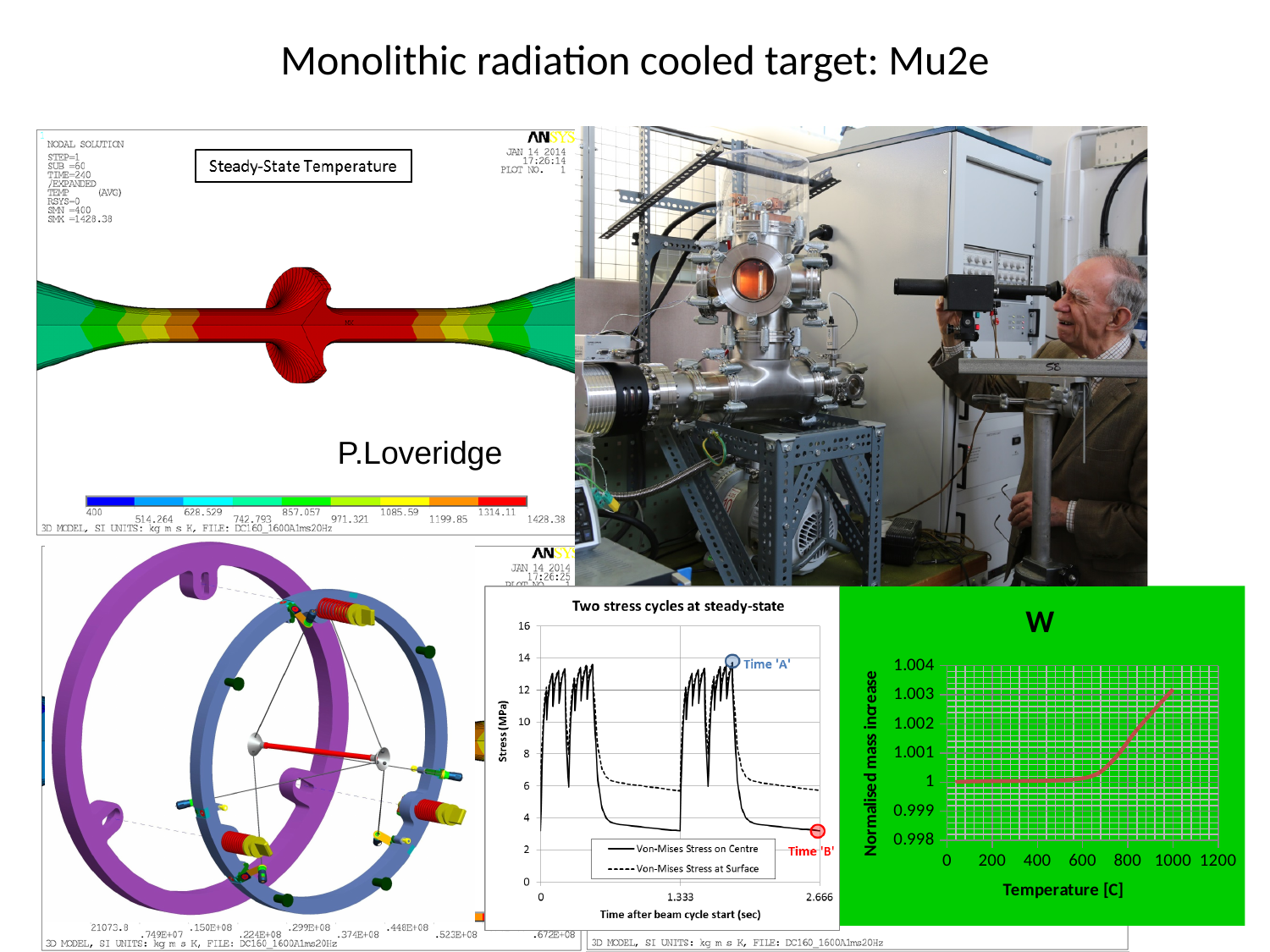
In the 'Two stress cycles at steady-state' chart, is the peak Von-Mises Stress on Centre greater or less than 12 MPa? greater In the 'Two stress cycles at steady-state' chart, what is the largest tick value shown on the x axis? 2.666 In the 'Two stress cycles at steady-state' chart, is the Von-Mises Stress on Centre at Time 'B' greater or less than 4 MPa? less In the 'Two stress cycles at steady-state' chart, how many series does the legend list? 2 What kind of chart is 'Two stress cycles at steady-state'? line chart What kind of chart is the 'W' chart on the green background? line chart In the 'Two stress cycles at steady-state' chart, what is the label of the x axis? Time after beam cycle start (sec) In the 'Two stress cycles at steady-state' chart, what is the label of the y axis? Stress (MPa) In the 'W' chart, does the normalised mass increase rise or fall as temperature increases from 600 to 1000 C? rise In the 'Two stress cycles at steady-state' chart, what are the two legend entries? Von-Mises Stress on Centre; Von-Mises Stress at Surface In the 'W' chart, is the normalised mass increase at 1000 C greater or less than 1.002? greater What is the title of the chart in the lower middle of the slide? Two stress cycles at steady-state